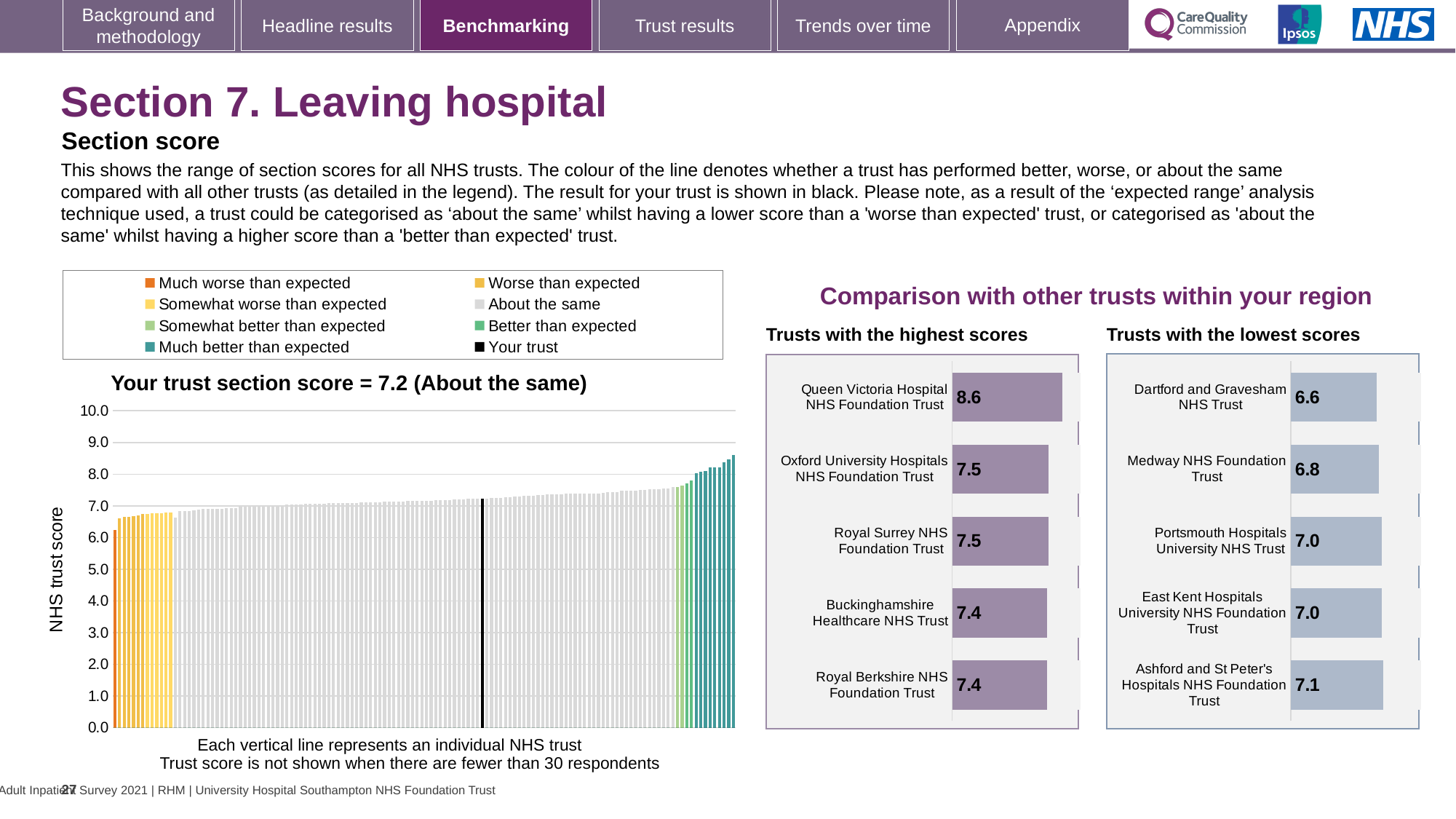
What is the y-axis label of the 'Your trust section score' chart? NHS trust score In the 'Trusts with the highest scores' chart, what is the difference between the scores of Queen Victoria Hospital NHS Foundation Trust and Royal Berkshire NHS Foundation Trust? 1.2 What kind of chart is the 'Your trust section score' chart? bar chart In the 'Trusts with the lowest scores' chart, which has the larger score: Medway NHS Foundation Trust or Ashford and St Peter's Hospitals NHS Foundation Trust? Ashford and St Peter's Hospitals NHS Foundation Trust How many trusts are shown in the 'Trusts with the highest scores' chart? 5 In the 'Trusts with the highest scores' chart, what is the score for Queen Victoria Hospital NHS Foundation Trust? 8.6 In the 'Trusts with the lowest scores' chart, what is the score for Medway NHS Foundation Trust? 6.8 How many categories does the legend above the 'Your trust section score' chart list? 8 In the 'Your trust section score' chart, what is the section score for your trust? 7.2 In the 'Your trust section score' chart, do the trust scores rise or fall from left to right? rise In the 'Trusts with the highest scores' chart, which trust has the highest score? Queen Victoria Hospital NHS Foundation Trust In the 'Trusts with the lowest scores' chart, which trust has the lowest score? Dartford and Gravesham NHS Trust